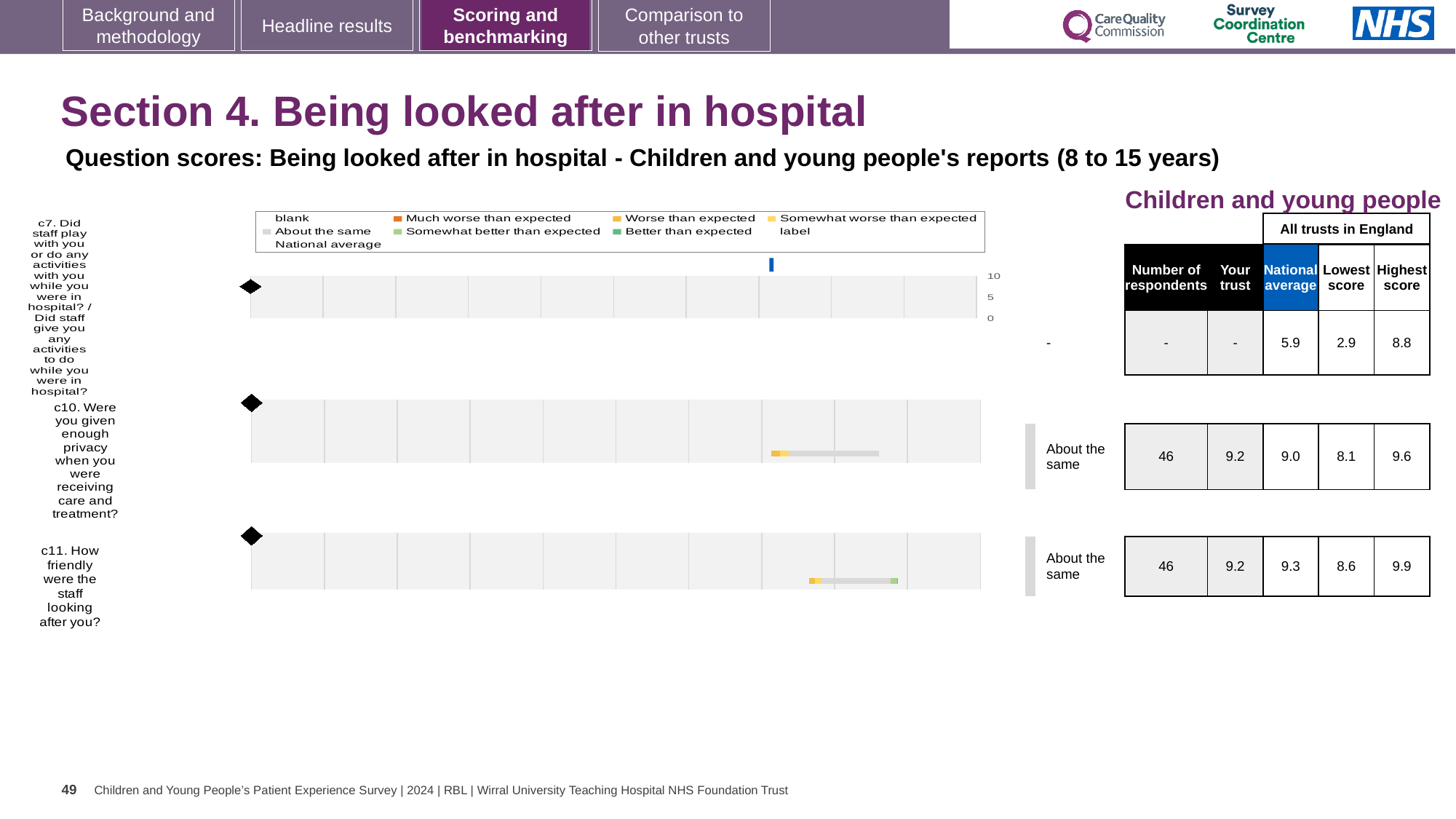
What is the national average for c11 (How friendly were the staff looking after you?)? 9.3 What kind of chart is used to show the question scores on this slide? bar chart What benchmark category is shown for c11 (How friendly were the staff looking after you?)? About the same What is the difference between the highest and lowest scores across all trusts for c11? 1.3 What is the lowest score across all trusts in England for c10? 8.1 What is the trust's score for c10 (Were you given enough privacy when you were receiving care and treatment?)? 9.2 Is the trust's score for c10 larger or smaller than the national average for c10? larger How many survey questions are plotted in the chart? 3 What is the highest score across all trusts in England for c7 (Did staff play with you or do any activities with you while you were in hospital?)? 8.8 How many respondents answered c11? 46 Which question has the lowest national average? c7 Which question has the highest 'Highest score' across all trusts in England? c11